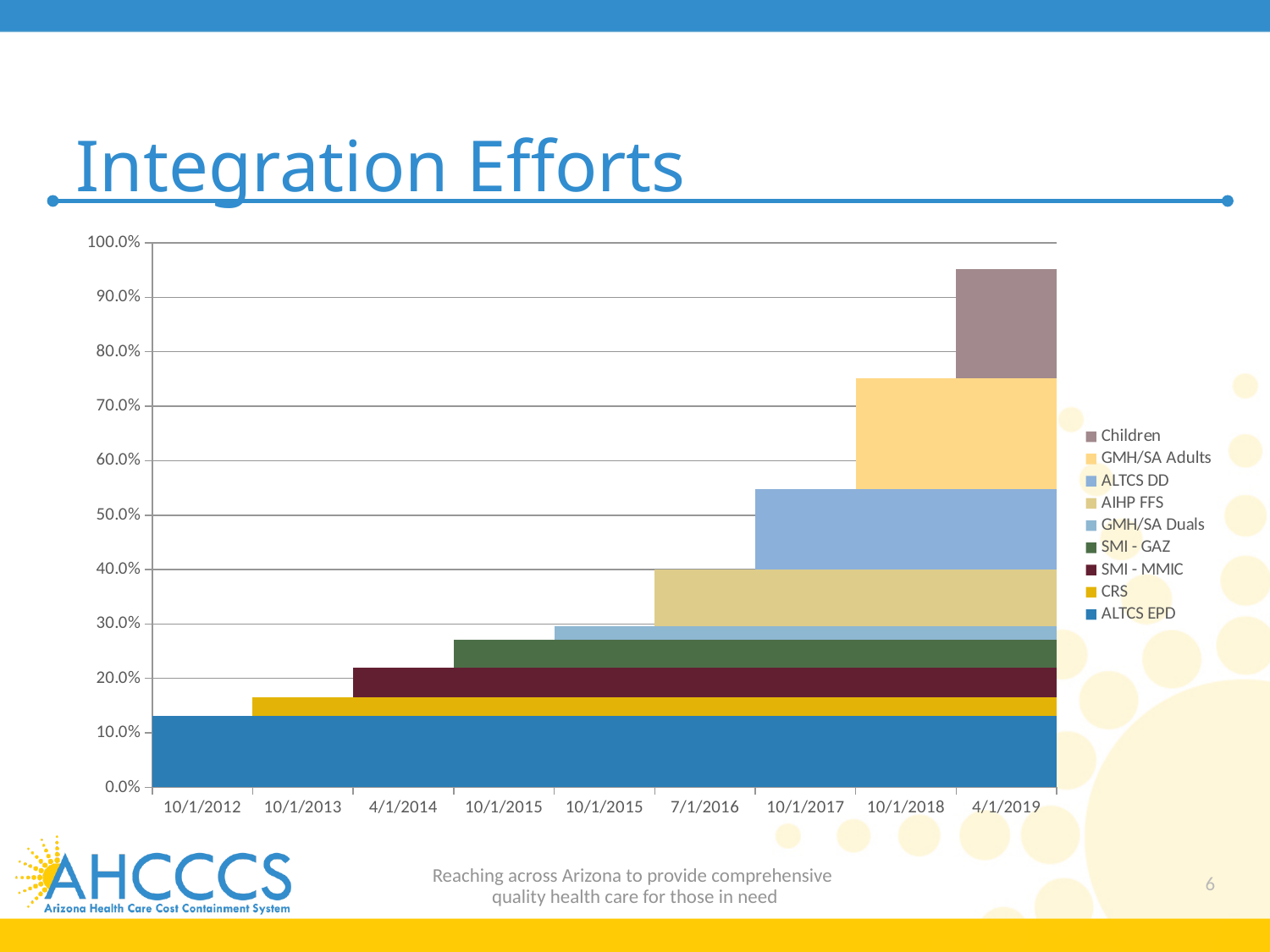
Which series forms the bottom segment of every stacked bar? ALTCS EPD How many dates are shown along the x axis? 9 What is the title of the chart on the slide? Integration Efforts Is the total stacked value for 10/1/2017 greater or less than 50.0%? greater Which date has the highest total stacked value? 4/1/2019 What kind of chart is shown on the slide? stacked bar chart How many series does the legend list? 9 Do the total stacked values rise or fall from 10/1/2012 to 4/1/2019? rise Which date has the lowest total stacked value? 10/1/2012 Which has the larger total stacked value, 10/1/2018 or 10/1/2017? 10/1/2018 Is the total stacked value for 4/1/2019 greater or less than 90.0%? greater Is the total stacked value for 10/1/2013 greater or less than 20.0%? less